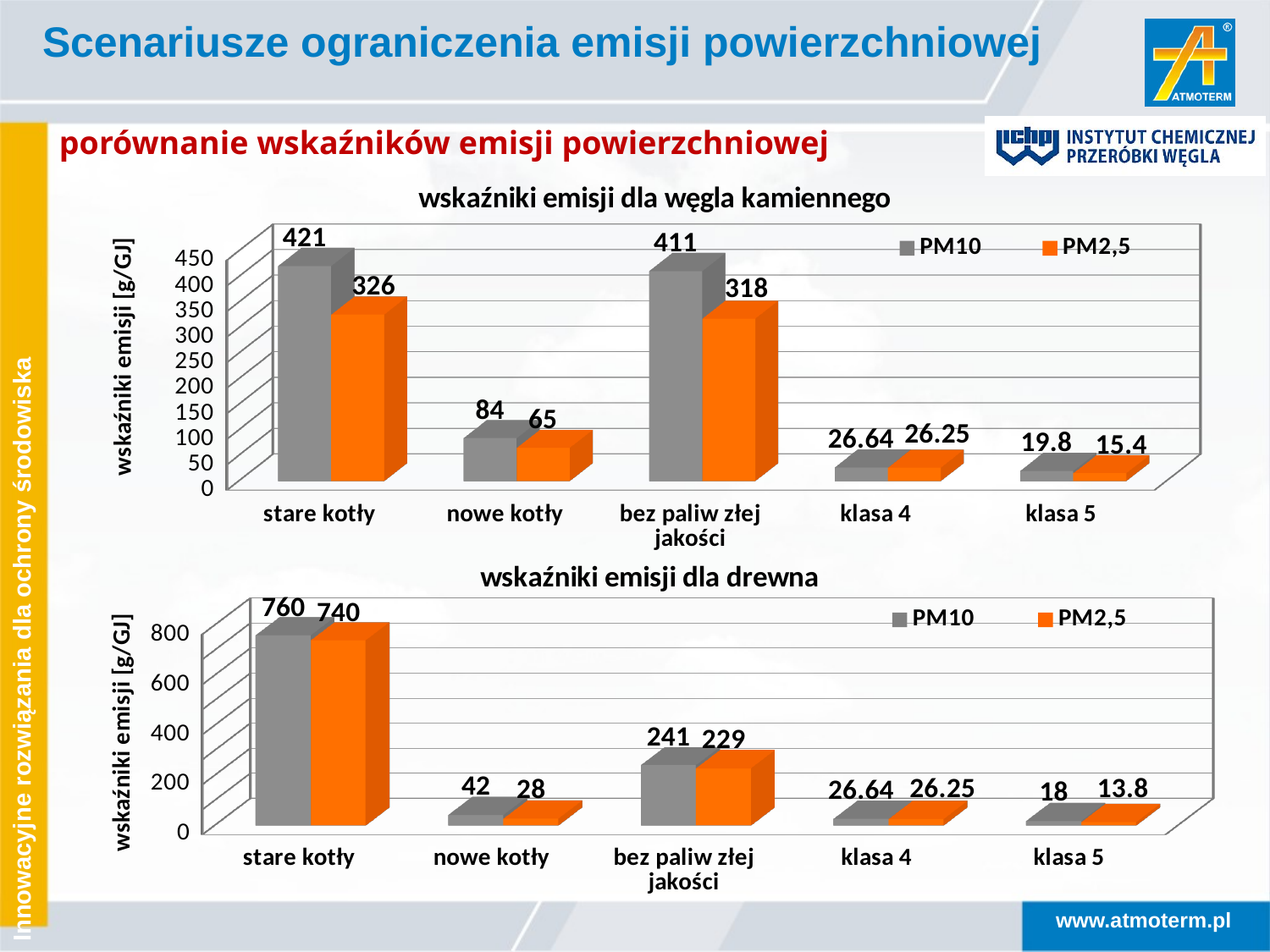
In the chart 'wskaźniki emisji dla drewna', how many series does the legend list? 2 In the chart 'wskaźniki emisji dla węgla kamiennego', what is the difference between the PM10 and PM2,5 values for 'nowe kotły'? 19 In the chart 'wskaźniki emisji dla drewna', which is larger: the PM10 value for 'bez paliw złej jakości' or the PM10 value for 'nowe kotły'? bez paliw złej jakości In the chart 'wskaźniki emisji dla węgla kamiennego', what is the PM10 value for 'stare kotły'? 421 In the chart 'wskaźniki emisji dla drewna', which category has the highest PM10 value? stare kotły In the chart 'wskaźniki emisji dla węgla kamiennego', how many categories are shown on the x axis? 5 What kind of chart is 'wskaźniki emisji dla węgla kamiennego'? bar chart In the chart 'wskaźniki emisji dla drewna', what is the PM10 value for 'stare kotły'? 760 In the chart 'wskaźniki emisji dla drewna', what is the difference between the PM10 and PM2,5 values for 'bez paliw złej jakości'? 12 In the chart 'wskaźniki emisji dla węgla kamiennego', what is the PM2,5 value for 'bez paliw złej jakości'? 318 In the chart 'wskaźniki emisji dla węgla kamiennego', which category has the lowest PM2,5 value? klasa 5 In the chart 'wskaźniki emisji dla drewna', what is the PM2,5 value for 'klasa 5'? 13.8